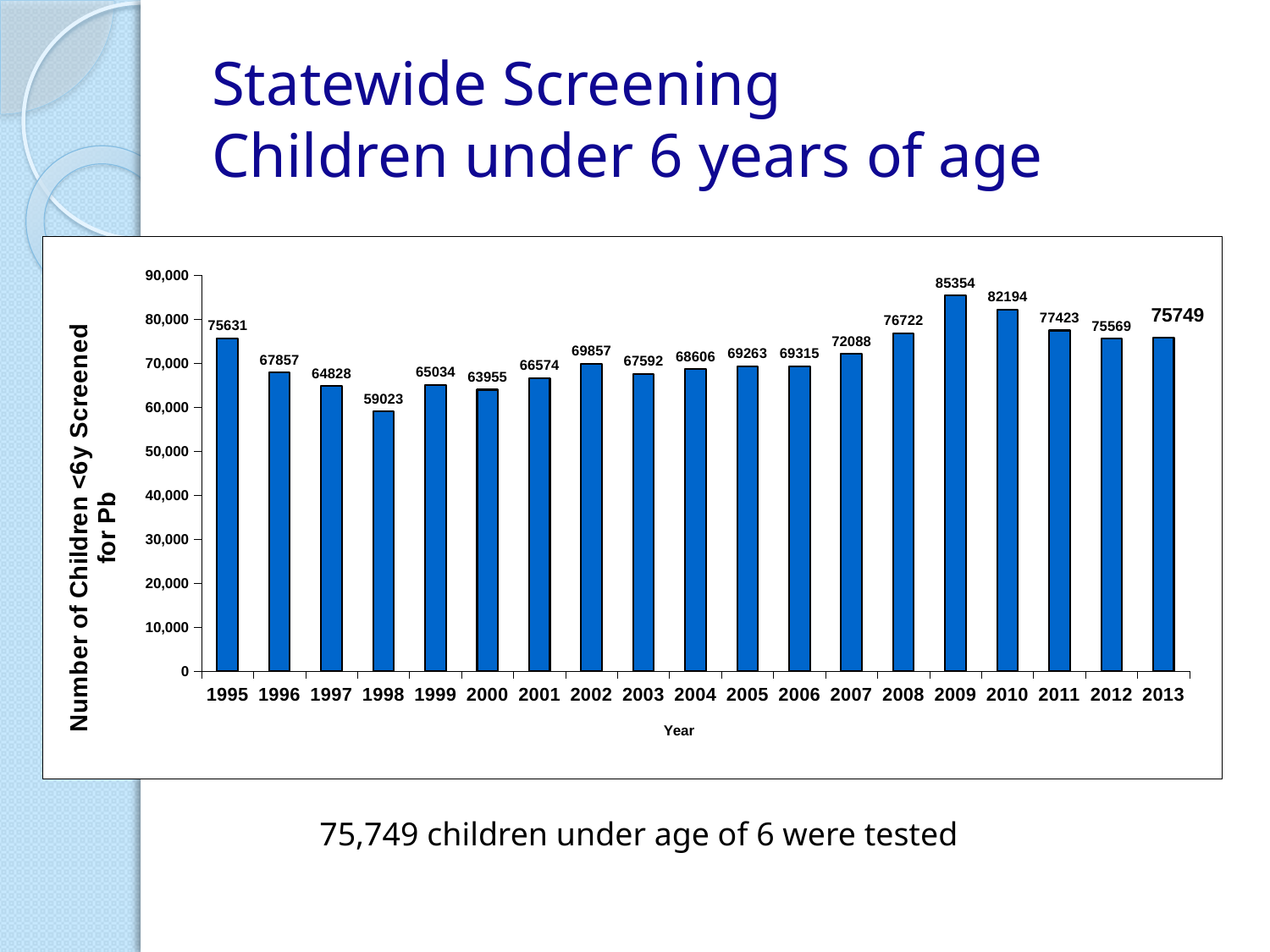
Which year had more children screened, 2007 or 2011? 2011 Do the values rise or fall from 1998 to 2009? rise What kind of chart is shown on the slide? bar chart How many children under 6 were screened for Pb in 2009? 85354 How many years are shown on the x axis? 19 Is the value for 1998 greater or less than 60,000? less What value is shown for 2013? 75749 Which year has the lowest number of children screened? 1998 Which year has the highest number of children screened? 2009 What is the difference between the number screened in 2009 and in 2010? 3160 What is the label of the y axis? Number of Children <6y Screened for Pb What is the number of children screened in 1998? 59023